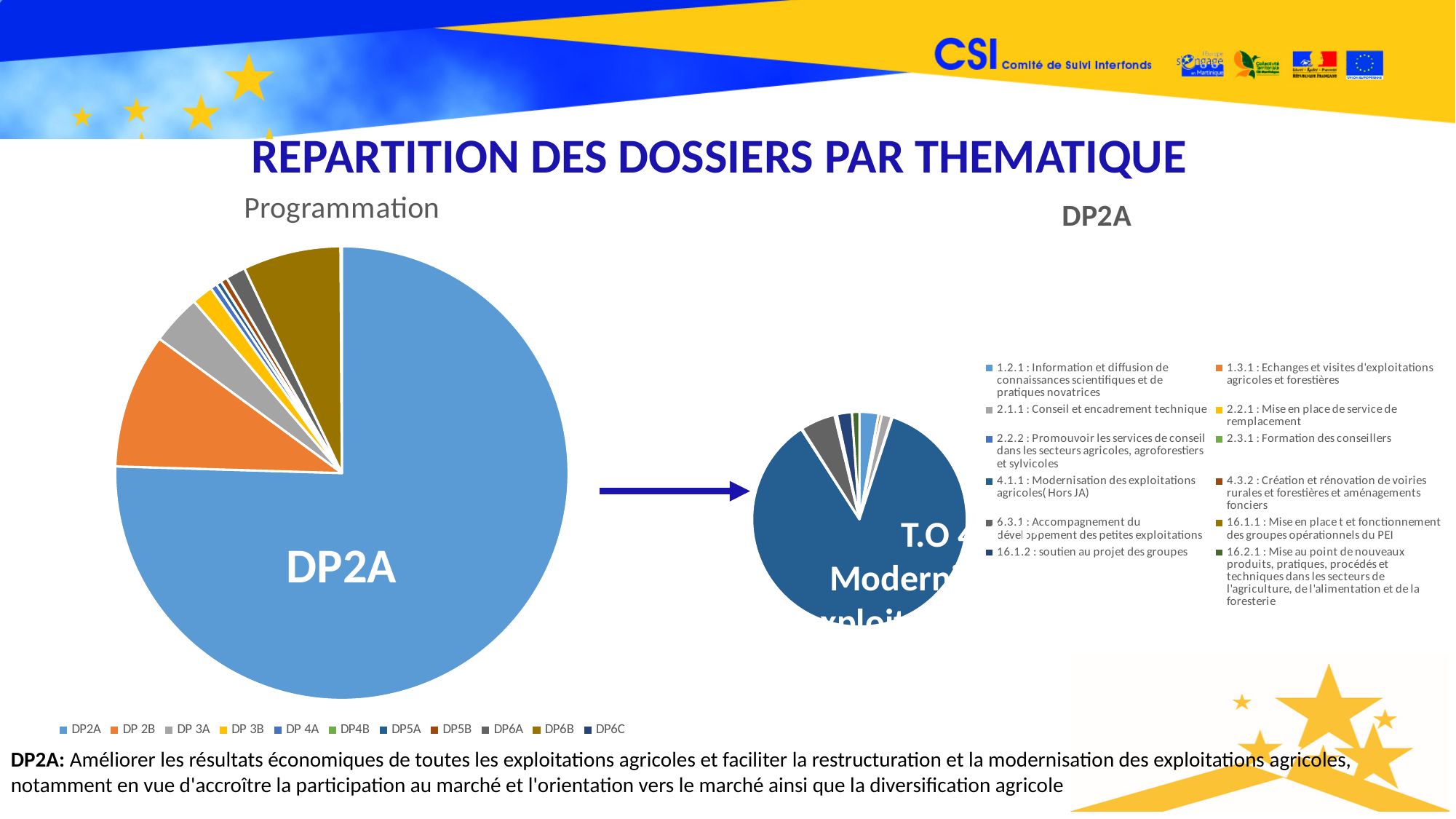
In the "DP2A" pie chart, which category has the largest slice? 4.1.1 : Modernisation des exploitations agricoles( Hors JA) In the "Programmation" pie chart, which slice is larger, DP 2B or DP 3A? DP 2B In the "Programmation" pie chart, which slice is larger, DP2A or DP 2B? DP2A In the "Programmation" pie chart, which slice is larger, DP6B or DP 3A? DP6B How many categories does the legend of the "Programmation" pie chart list? 11 In the "Programmation" pie chart, which category has the largest slice? DP2A How many categories does the legend of the "DP2A" pie chart list? 12 In the "Programmation" pie chart, which category has the second largest slice? DP 2B What kind of chart is the "Programmation" chart on the left of the slide? Pie chart What is the title of the slide above the two pie charts? REPARTITION DES DOSSIERS PAR THEMATIQUE What is the title of the pie chart on the left of the slide? Programmation What kind of chart is the "DP2A" chart on the right of the slide? Pie chart